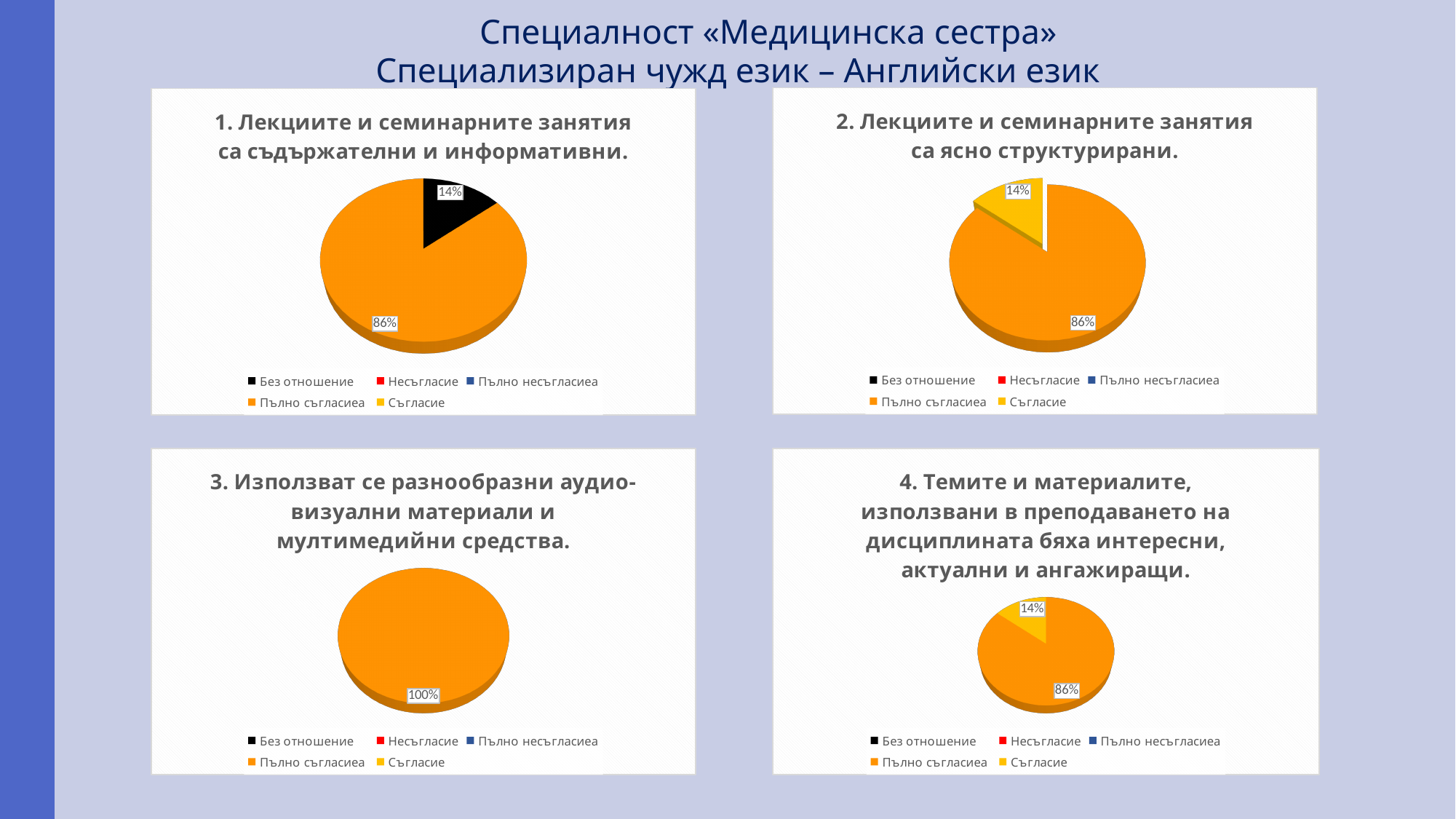
In the bottom-right chart (4. Темите и материалите, използвани в преподаването на дисциплината бяха интересни, актуални и ангажиращи.), what share is shown for Пълно съгласиеа? 86% How many entries does the legend of the top-left chart (1. Лекциите и семинарните занятия са съдържателни и информативни.) list? 5 In the top-right chart (2. Лекциите и семинарните занятия са ясно структурирани.), what colour is the Съгласие slice? Yellow In the top-right chart (2. Лекциите и семинарните занятия са ясно структурирани.), what is the difference between the Пълно съгласиеа slice and the Съгласие slice? 72% What kind of chart is used in the top-left chart titled "1. Лекциите и семинарните занятия са съдържателни и информативни."? Pie chart In the bottom-left chart (3. Използват се разнообразни аудио-визуални материали и мултимедийни средства.), what share is shown for Пълно съгласиеа? 100% In the bottom-right chart (4. Темите и материалите...), which is larger, the Съгласие slice or the Пълно съгласиеа slice? Пълно съгласиеа In the top-left chart (1. Лекциите и семинарните занятия са съдържателни и информативни.), what share is shown for Пълно съгласиеа? 86% In the top-left chart (1. Лекциите и семинарните занятия са съдържателни и информативни.), which category has the largest slice? Пълно съгласиеа In the bottom-left chart (3. Използват се разнообразни аудио-визуални материали и мултимедийни средства.), how many slices does the pie have? 1 In the top-right chart (2. Лекциите и семинарните занятия са ясно структурирани.), what share is shown for Съгласие? 14% In the top-left chart (1. Лекциите и семинарните занятия са съдържателни и информативни.), what share is shown for Без отношение? 14%